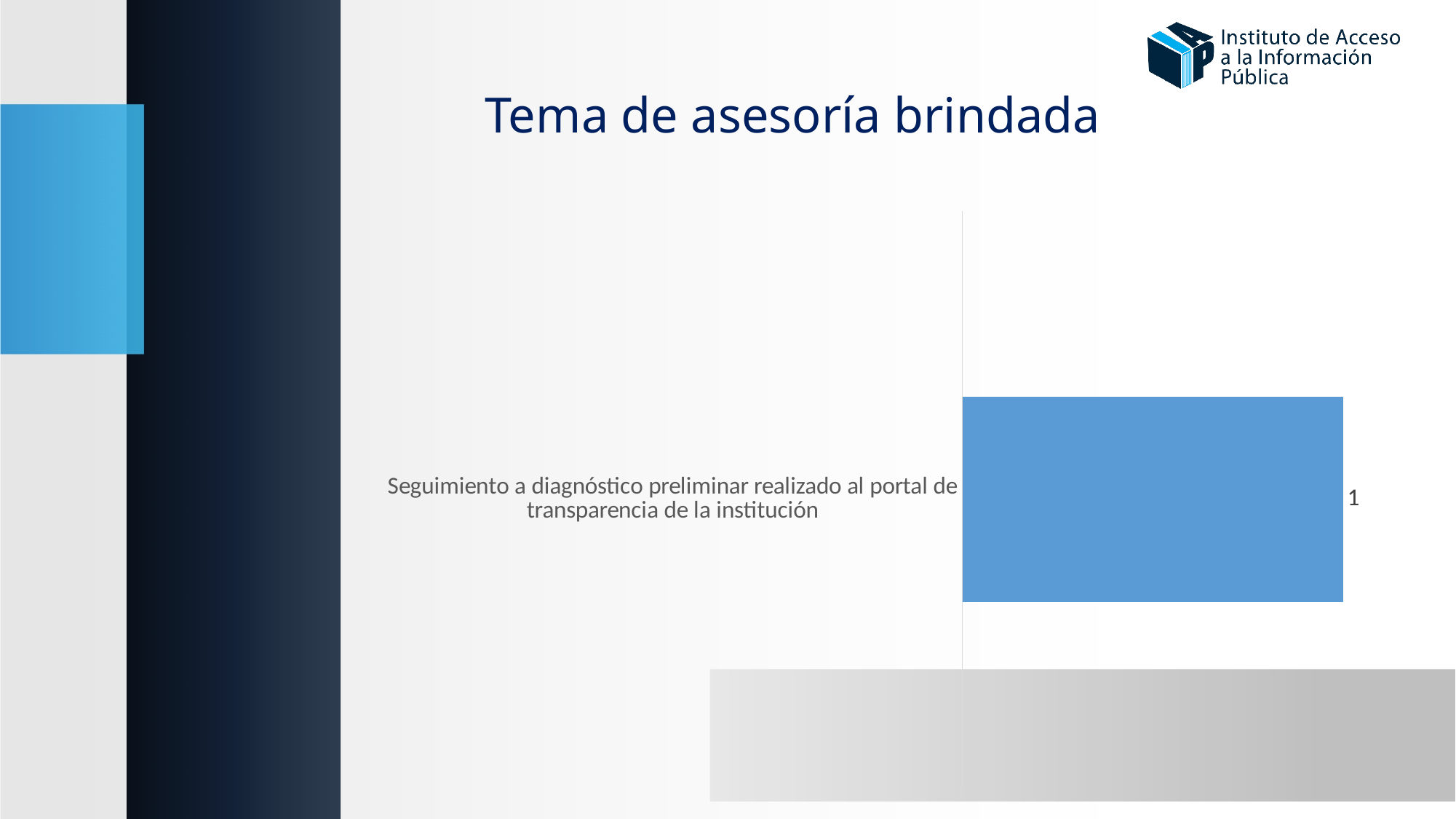
What is the title of the slide above the chart? Tema de asesoría brindada What is the value for "Seguimiento a diagnóstico preliminar realizado al portal de transparencia de la institución"? 1 Which category has the highest value in the chart? Seguimiento a diagnóstico preliminar realizado al portal de transparencia de la institución How many categories does the chart show? 1 What colour is the bar in the chart? blue What kind of chart is shown on the slide? bar chart